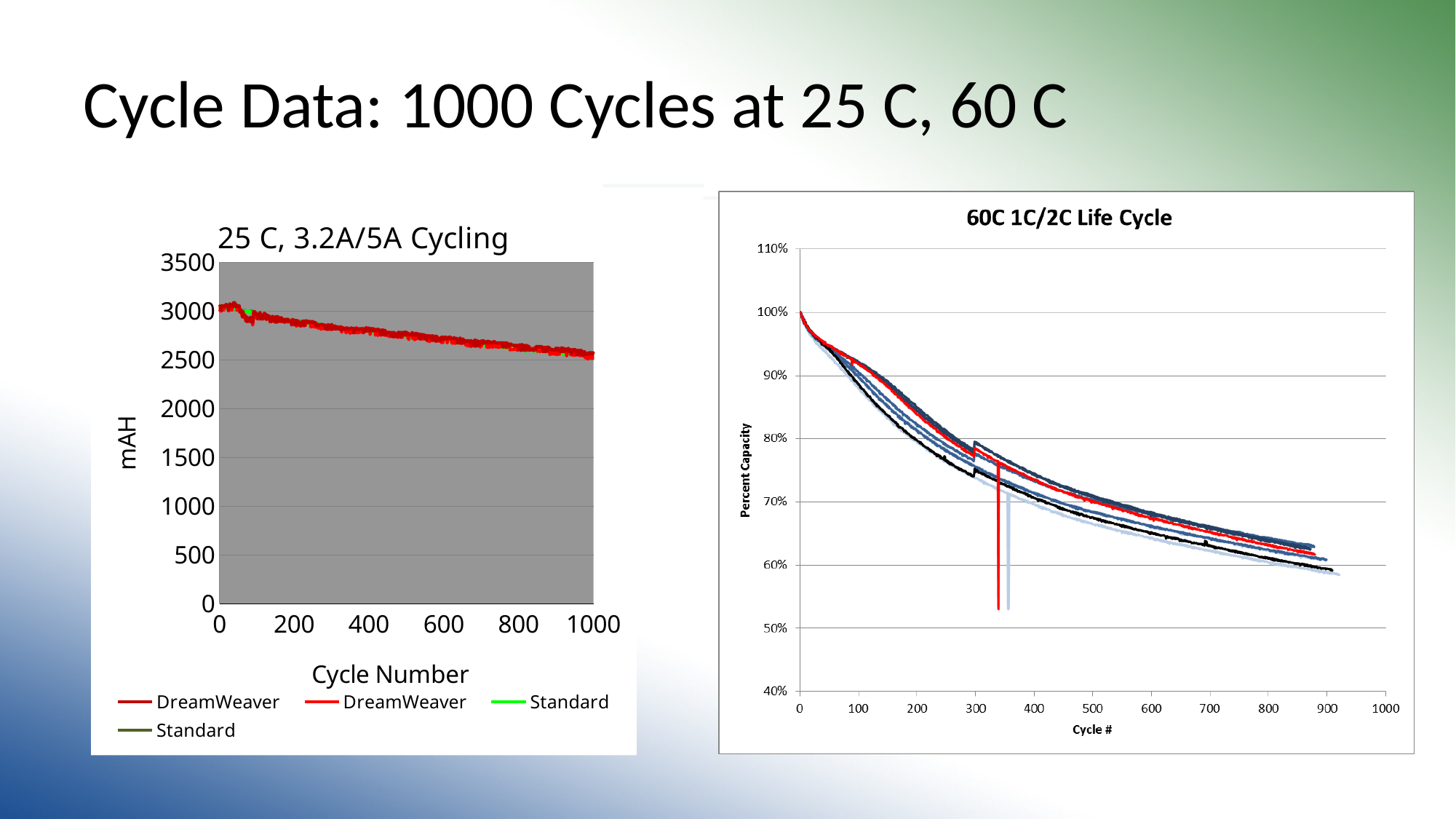
In the right chart "60C 1C/2C Life Cycle", is the percent capacity at cycle 900 greater or less than 70%? less In the right chart "60C 1C/2C Life Cycle", does percent capacity rise or fall as the cycle number increases? fall In the right chart "60C 1C/2C Life Cycle", at what percent capacity do the lines start at cycle 0? 100% What is the x-axis label of the right chart "60C 1C/2C Life Cycle"? Cycle # What type of chart is the right chart titled "60C 1C/2C Life Cycle"? line chart How many entries does the legend of the left chart "25 C, 3.2A/5A Cycling" list? 4 What type of chart is the left chart titled "25 C, 3.2A/5A Cycling"? line chart In the left chart "25 C, 3.2A/5A Cycling", is the mAH value at cycle 1000 greater or less than 3000? less In the left chart "25 C, 3.2A/5A Cycling", is the mAH value at cycle 0 greater or less than 2500? greater What is the y-axis label of the left chart "25 C, 3.2A/5A Cycling"? mAH In the left chart "25 C, 3.2A/5A Cycling", do the values rise or fall as the cycle number increases? fall